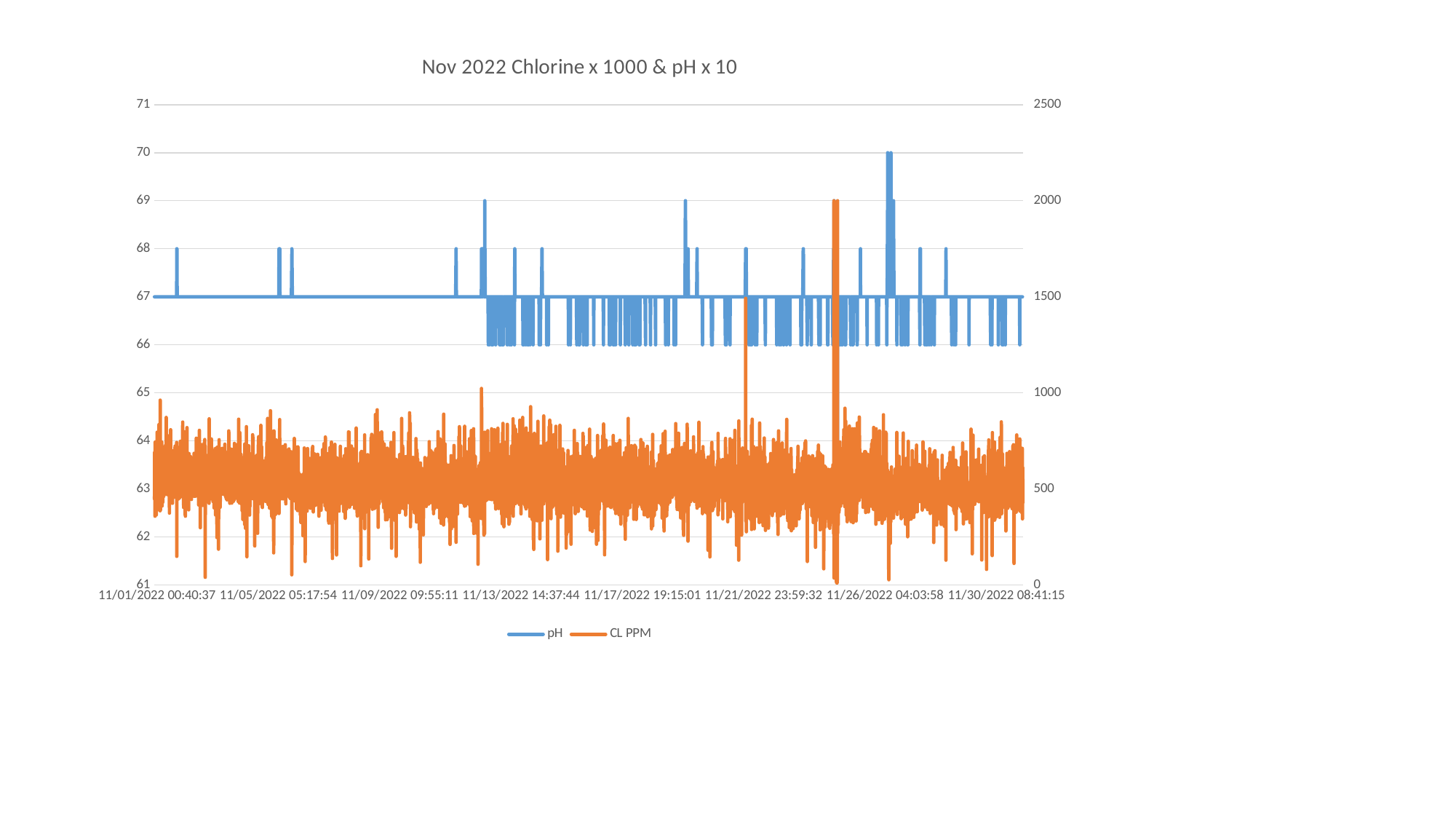
Is the pH value at 11/01/2022 00:40:37 greater or less than 65? greater Which pH spike is higher: the one near 11/26/2022 04:03:58 or the one near 11/13/2022 14:37:44? the one near 11/26/2022 04:03:58 What is the highest value reached by the CL PPM series on the right axis? 2000 Is the pH value at 11/30/2022 08:41:15 greater or less than 65? greater What are the two series named in the legend? pH and CL PPM Is the CL PPM value at 11/01/2022 00:40:37 greater or less than 1000? less How many series does the legend list? 2 What kind of chart is shown on the slide? line chart What is the title of the chart? Nov 2022 Chlorine x 1000 & pH x 10 What is the lowest value reached by the pH series on the left axis? 66 What is the pH value at the start of the period, 11/01/2022 00:40:37? 67 What is the highest value reached by the pH series on the left axis? 70